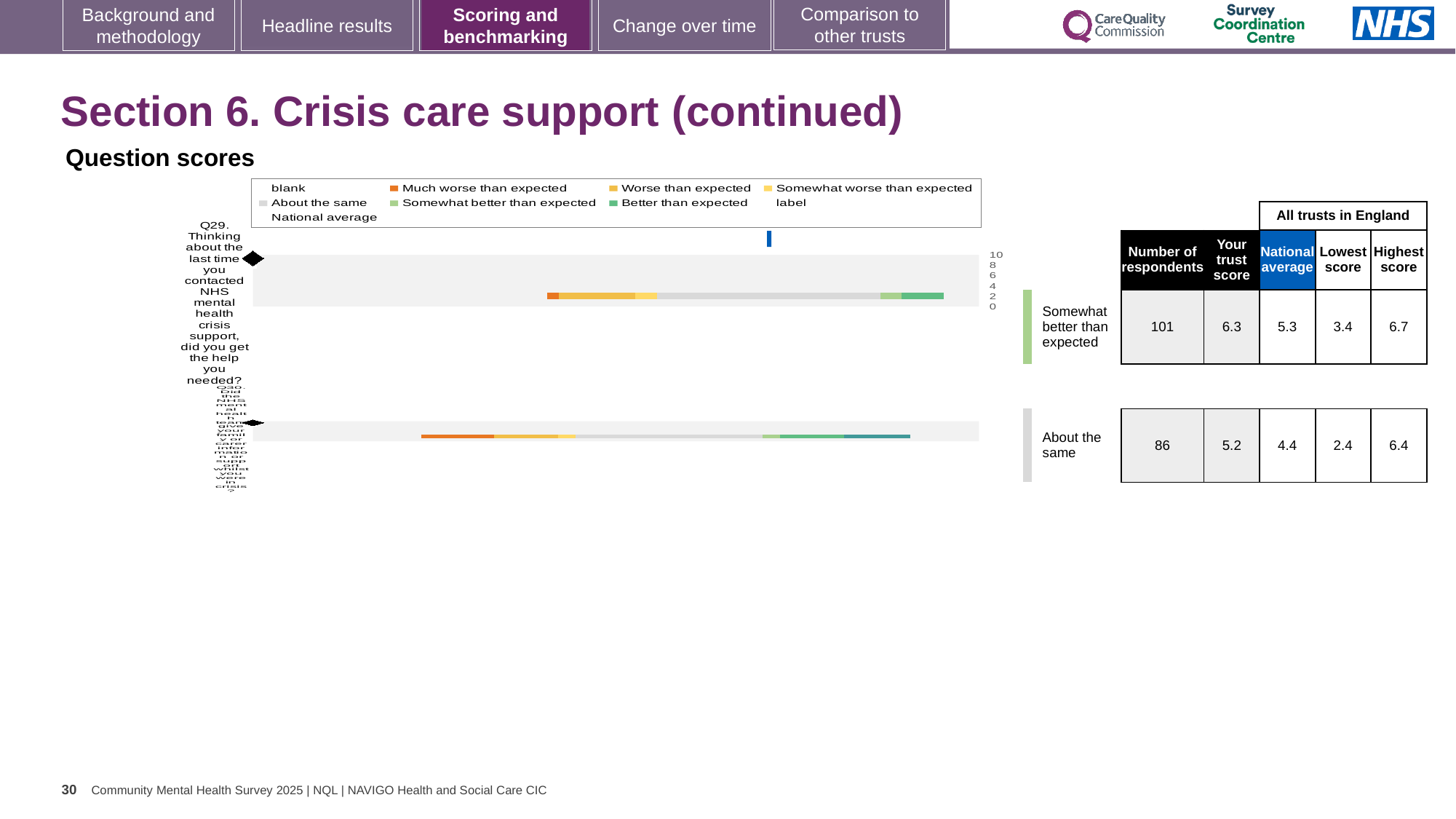
What is the lowest score among all trusts in England for Q29? 3.4 How many respondents are listed for Q29? 101 How many questions are plotted in the question scores chart? 2 What is the national average score for Q29? 5.3 By how much does the trust score for Q29 exceed the national average? 1.0 What is the difference between the highest and lowest scores for the second question (rated 'About the same')? 4.0 Which is larger for Q29: the trust score or the national average? The trust score (6.3) What is the 'Your trust score' for Q29 (Thinking about the last time you contacted NHS mental health crisis support, did you get the help you needed?)? 6.3 What kind of chart is used to show the question scores on this slide? Bar chart Which benchmark category is shown for Q29? Somewhat better than expected What is the highest score among all trusts in England for Q29? 6.7 What is the 'Your trust score' for the second question in the chart (the one rated 'About the same')? 5.2